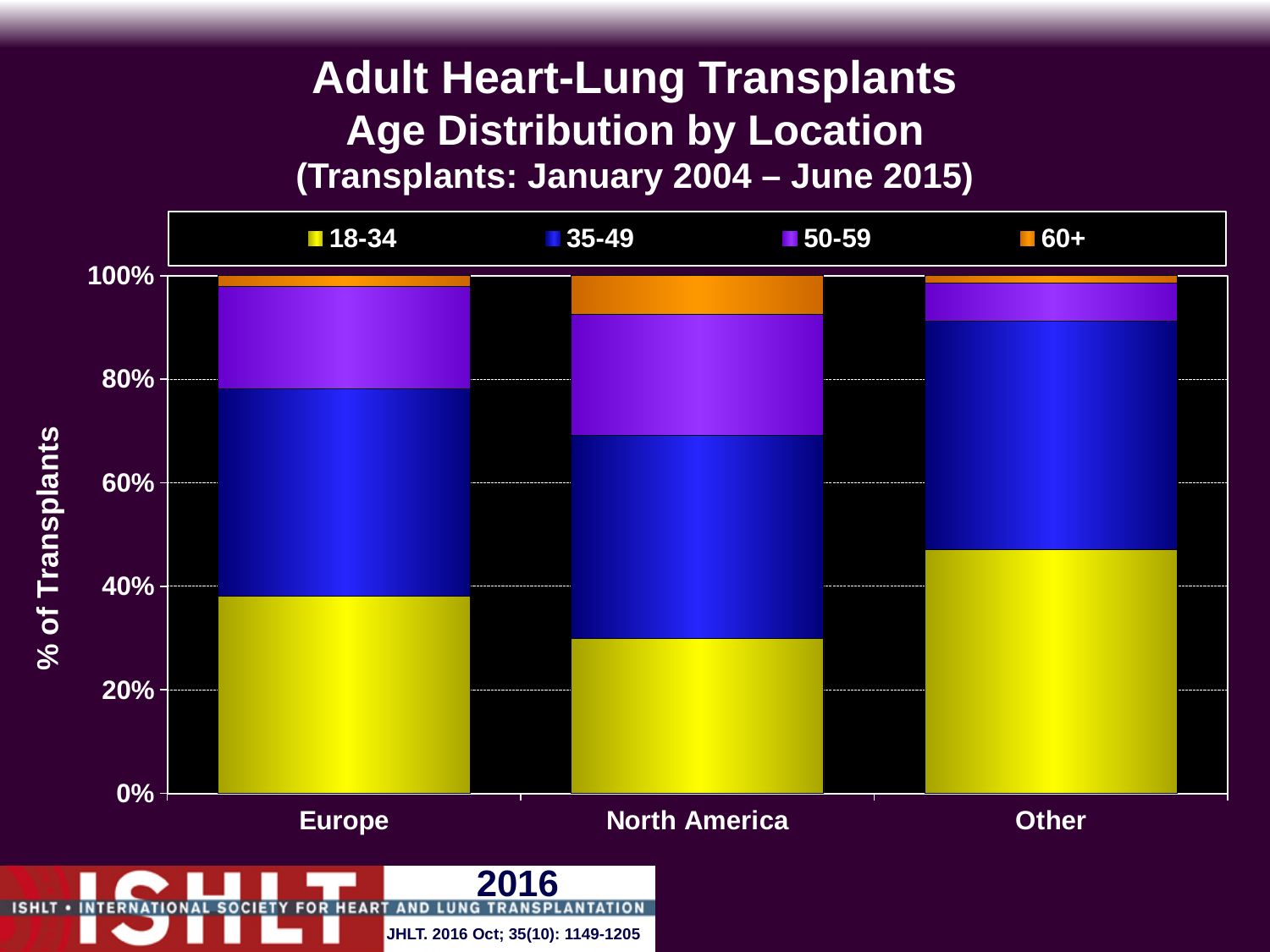
Is the 18-34 share for Other greater or less than 40%? greater Which location has the smallest 18-34 share of transplants? North America Is the 50-59 share larger for North America or for Other? North America Is the 18-34 share for Europe greater or less than 40%? less How many age groups does the legend list? 4 Which location has the largest 60+ share of transplants? North America What is the total height of each stacked bar in the chart? 100% Which age group is shown in yellow in the legend? 18-34 Is the 18-34 share for North America greater or less than 20%? greater What kind of chart is shown on the slide? Stacked bar chart How many locations are shown on the x axis of the chart? 3 Which location has the largest 18-34 share of transplants? Other